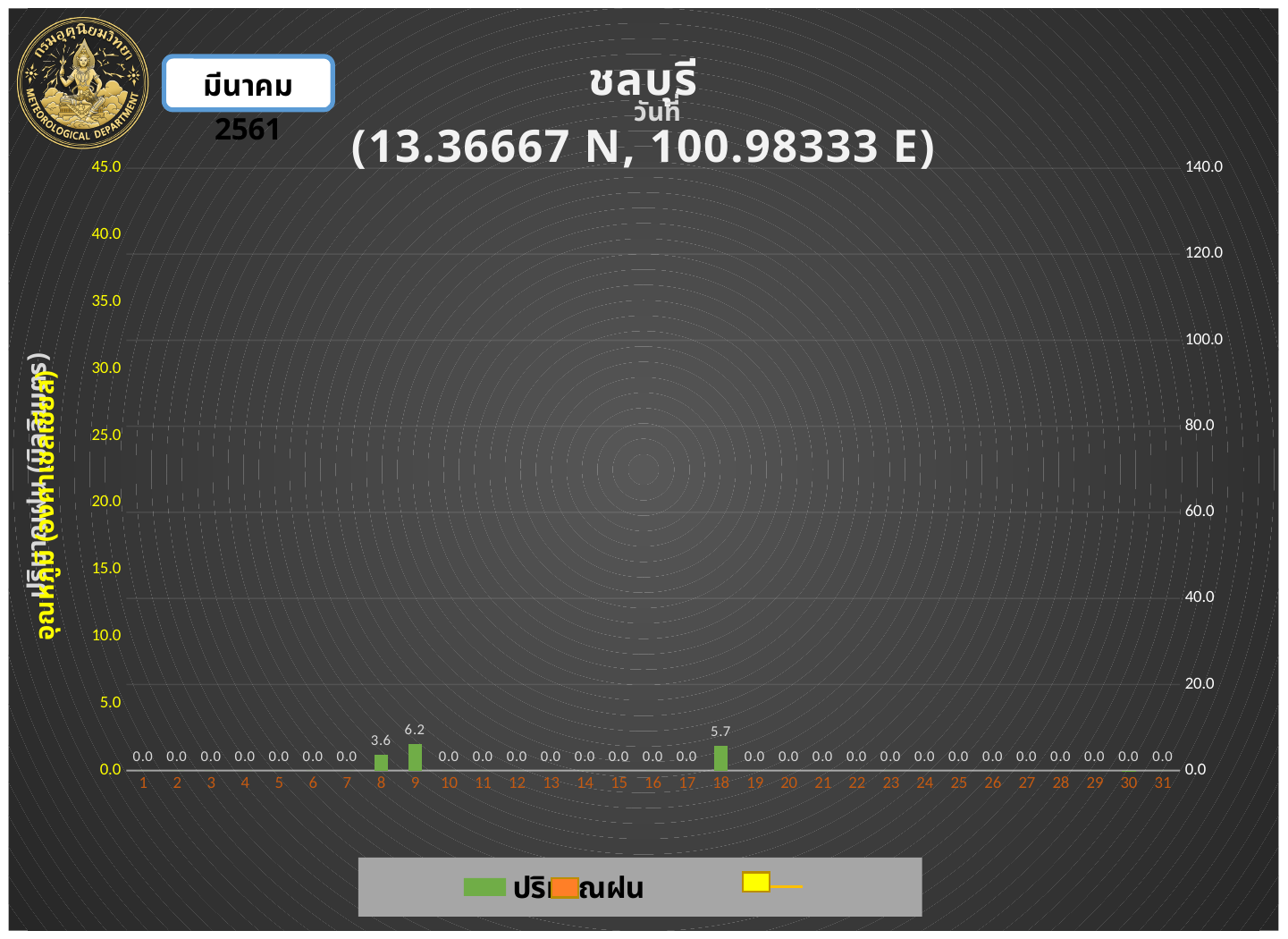
What is the difference between the rainfall values for day 9 and day 18? 0.5 What is the highest tick value shown on the right-hand axis? 140.0 How many days are shown along the x axis? 31 What is the rainfall value shown for day 15? 0.0 What is the rainfall value shown for day 8? 3.6 What kind of chart is shown on the slide? bar chart Which day has the highest rainfall value? 9 What is the difference between the rainfall values for day 9 and day 8? 2.6 Is the rainfall value for day 9 greater or less than 10.0 on the left axis? less What is the rainfall value shown for day 9? 6.2 What is the rainfall value shown for day 18? 5.7 Which is larger, the rainfall value for day 8 or for day 18? day 18